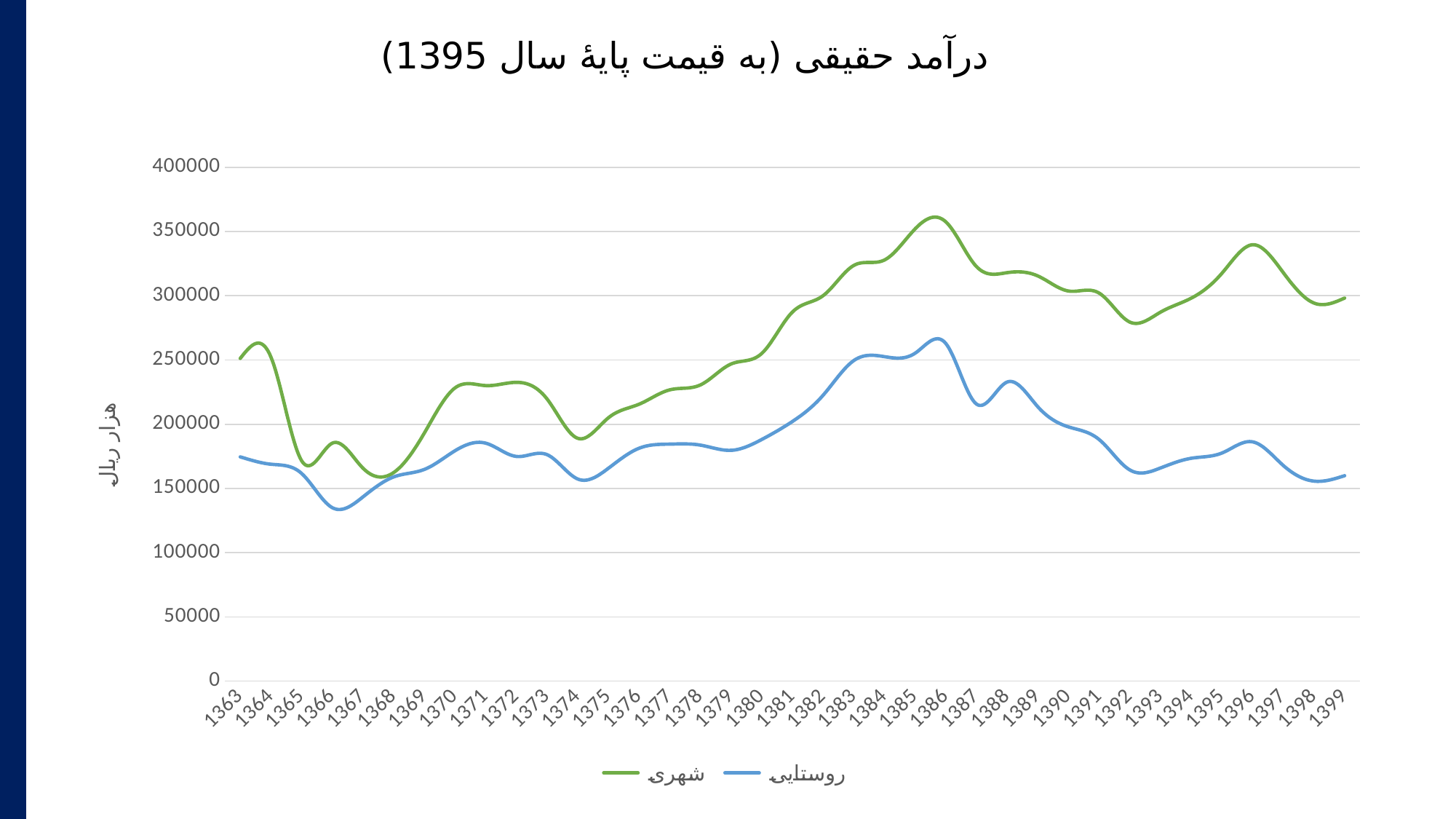
Is the value for روستایی in 1366 greater or less than 150000? less In which year does the روستایی series reach its lowest value? 1366 In which year does the شهری series reach its highest value? 1386 Does the روستایی series rise or fall from 1386 to 1392? fall How many years are plotted along the x axis? 37 What kind of chart is shown on the slide? line chart Is the value for شهری in 1386 greater or less than 350000? greater Which series has the larger value in 1396, شهری or روستایی? شهری How many series does the legend list? 2 In which year does the روستایی series reach its highest value? 1386 Is the value for شهری in 1374 greater or less than 200000? less